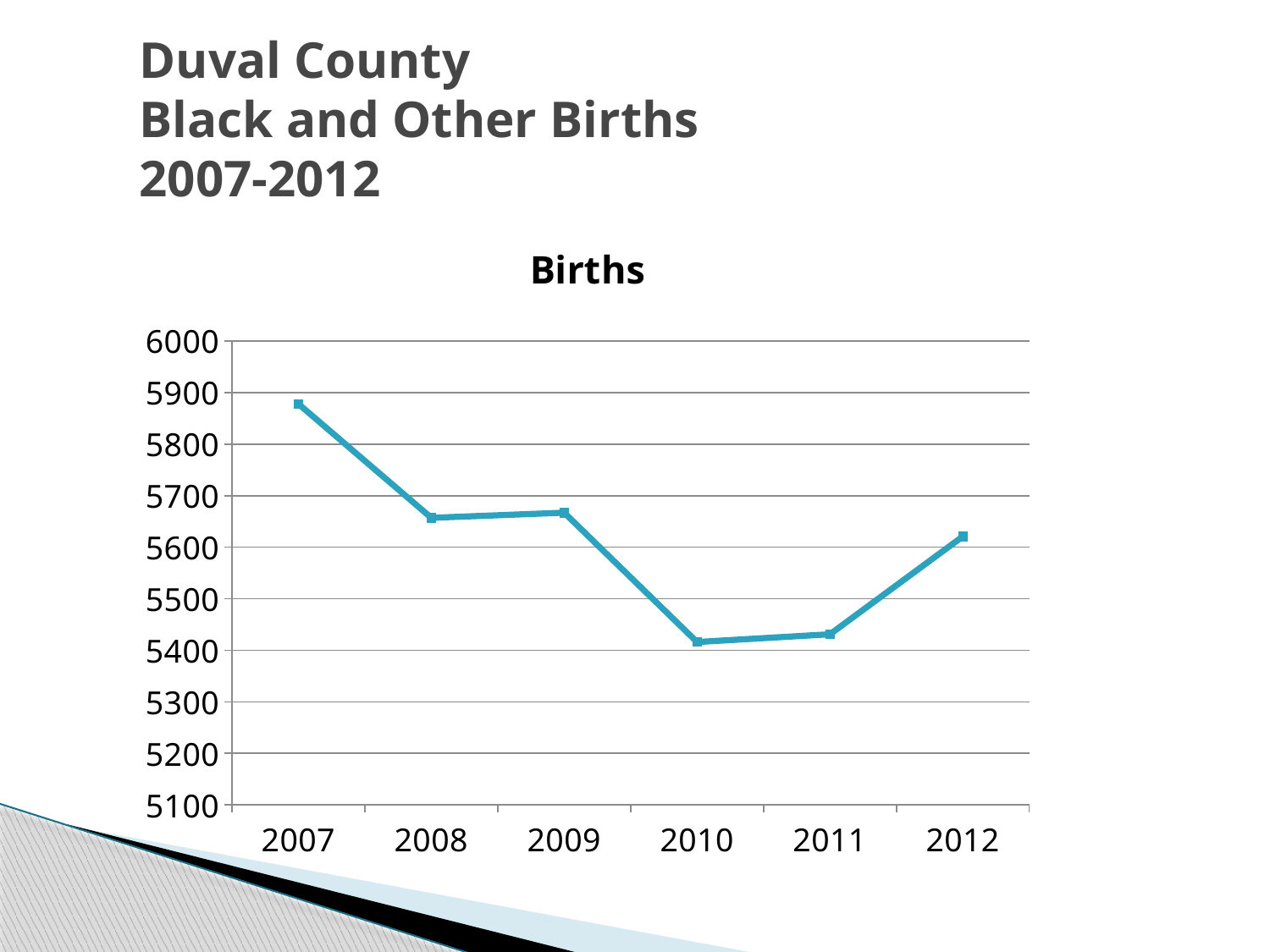
Do births rise or fall from 2007 to 2010? fall Is the value for 2007 greater or less than 5800? greater Is the value for 2011 greater or less than 5500? less Which year has more births, 2007 or 2012? 2007 Is the value for 2012 greater or less than 5700? less What kind of chart is shown on the slide? line chart What is the title of the chart? Births How many years are plotted on the x axis? 6 Which year has more births, 2009 or 2010? 2009 Which year has the highest number of births? 2007